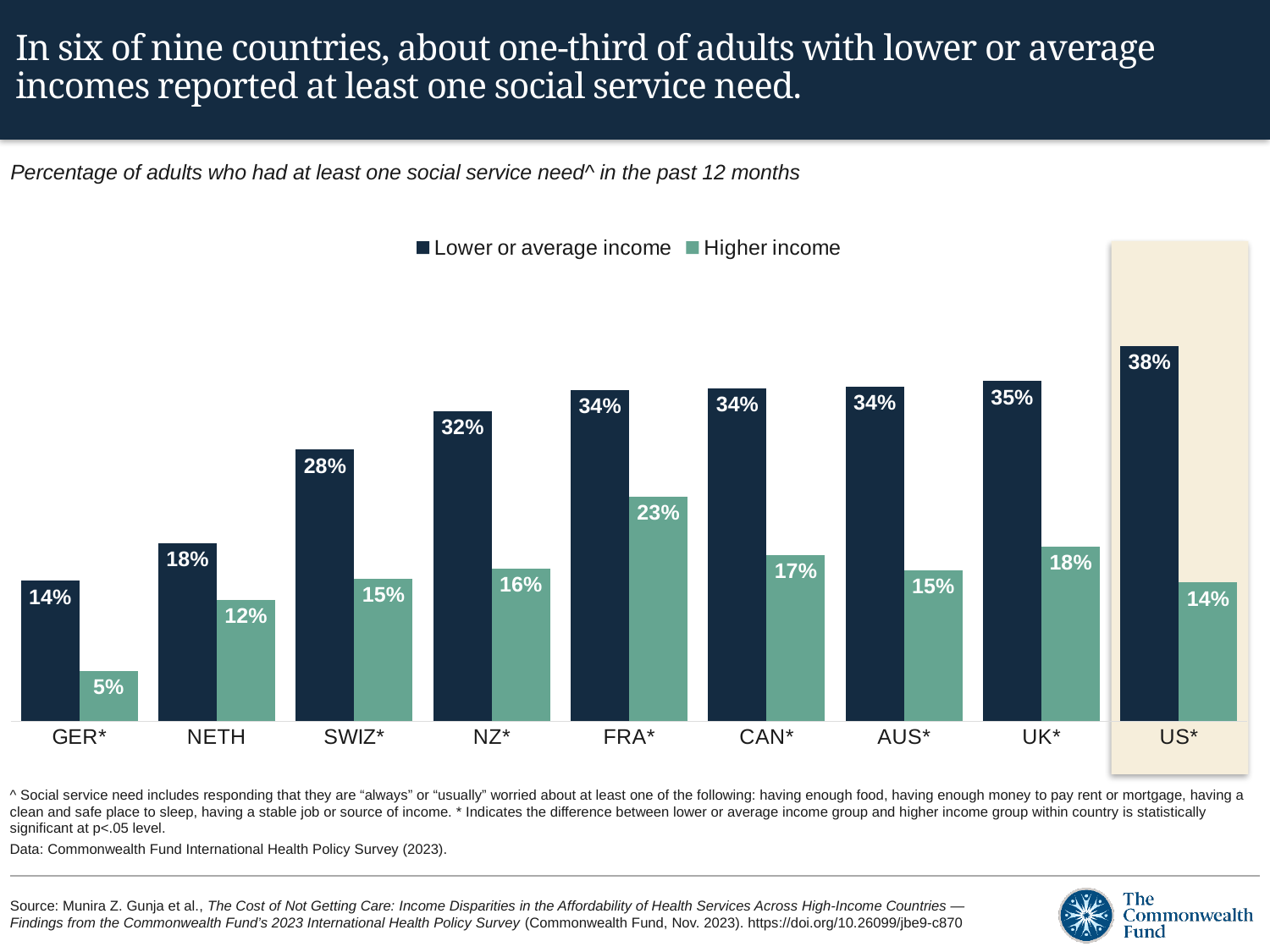
What is the difference between the Lower or average income values for NETH and GER*? 4 percentage points How many series does the legend list? 2 What is the value for the Lower or average income group in SWIZ*? 28% How many countries are shown on the x axis? 9 Which country's bars are highlighted with a shaded background? US* What kind of chart is shown on the slide? Bar chart Which country has the highest value for the Lower or average income group? US* Which country has the lowest value for the Higher income group? GER* What percentage of adults with lower or average income in the US* reported at least one social service need? 38% What is the difference between the Lower or average income and Higher income values in the US*? 24 percentage points What is the value for the Higher income group in FRA*? 23% Which is larger: the Higher income value for UK* or the Higher income value for CAN*? UK*